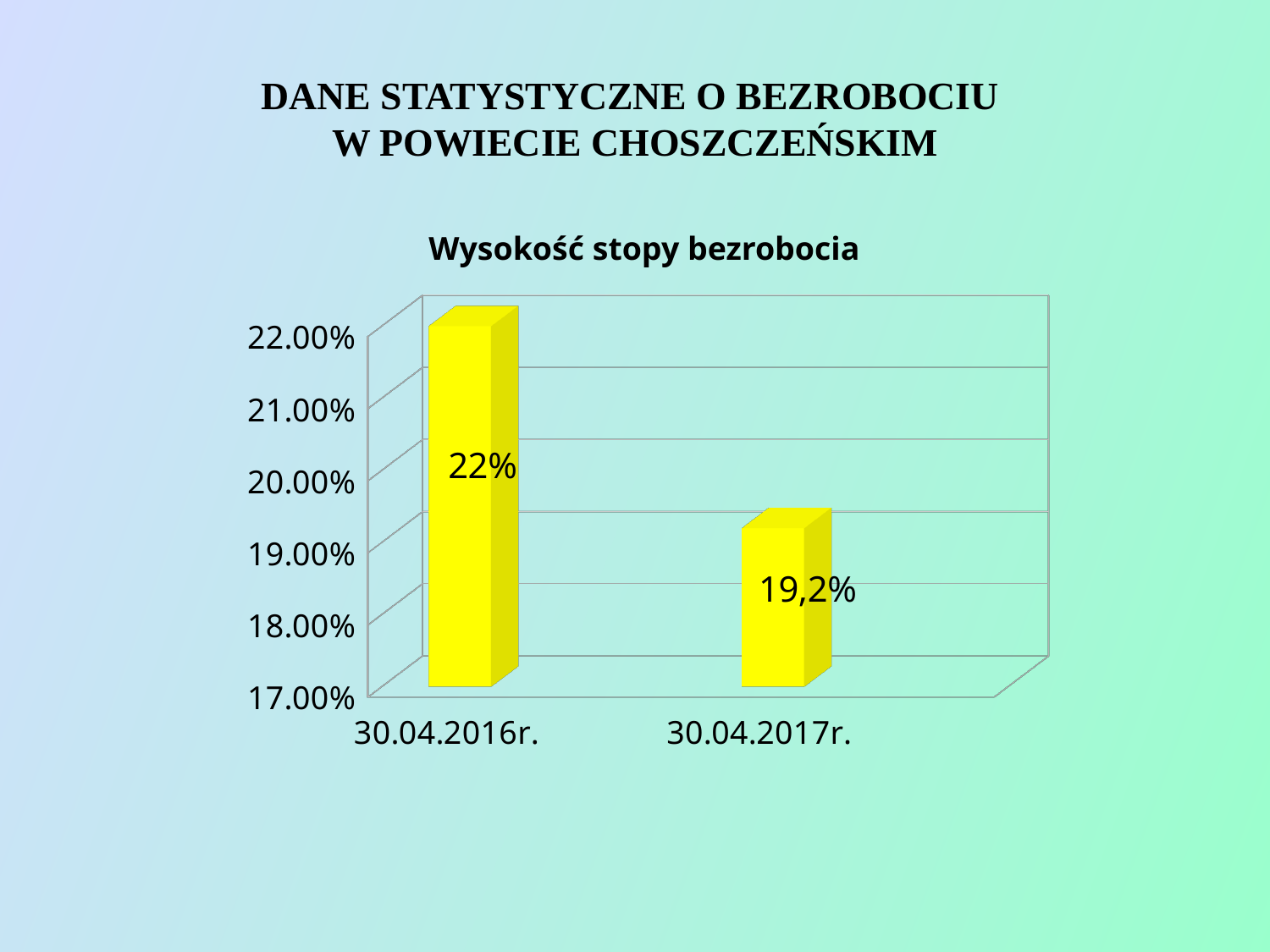
Is the value for 30.04.2017r. greater or less than 20.00%? less What is the unemployment rate shown for 30.04.2017r.? 19,2% Which date has the lower unemployment rate? 30.04.2017r. What is the unemployment rate shown for 30.04.2016r.? 22% How many dates (categories) are shown on the chart? 2 What colour are the bars in the chart? yellow Does the unemployment rate rise or fall from 30.04.2016r. to 30.04.2017r.? fall What is the title of the chart? Wysokość stopy bezrobocia What kind of chart is shown on the slide? bar chart Which date has the higher unemployment rate? 30.04.2016r. Is the value for 30.04.2016r. greater or less than 21.00%? greater